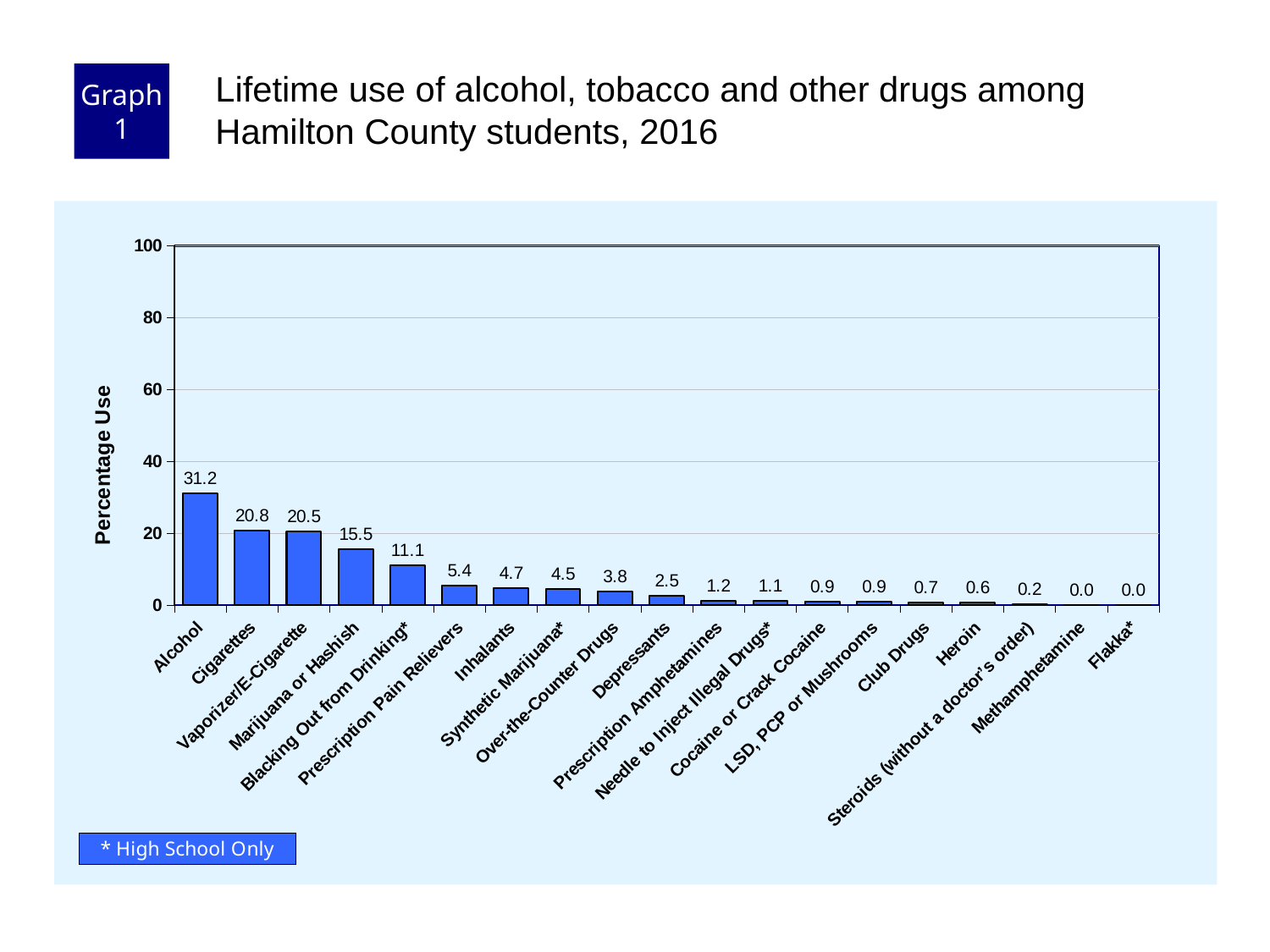
Is the value for Alcohol greater or less than 40? less Which categories have the lowest percentage use? Methamphetamine and Flakka* What is the percentage use for Vaporizer/E-Cigarette? 20.5 What is the difference in percentage use between Alcohol and Cigarettes? 10.4 What is the percentage use for Blacking Out from Drinking*? 11.1 What is the percentage use for Heroin? 0.6 Which has a higher percentage use, Inhalants or Over-the-Counter Drugs? Inhalants What is the difference in percentage use between Marijuana or Hashish and Prescription Pain Relievers? 10.1 What is the percentage use for Alcohol? 31.2 What kind of chart is shown on the slide? Bar chart Which category has the highest percentage use? Alcohol How many categories are shown on the x axis? 19